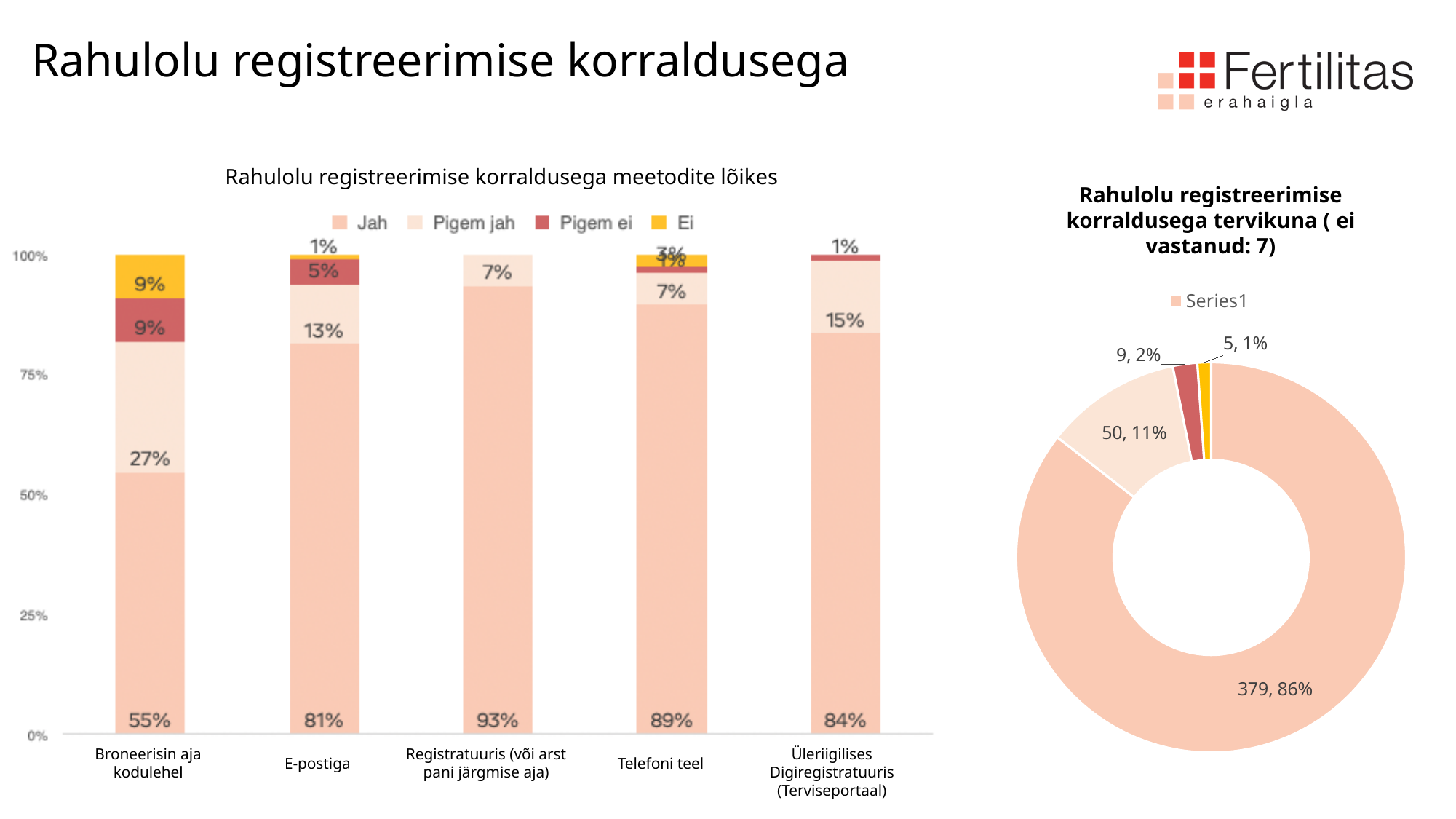
In the chart 'Rahulolu registreerimise korraldusega meetodite lõikes', is the 'Pigem jah' value larger for 'E-postiga' or for 'Üleriigilises Digiregistratuuris (Terviseportaal)'? Üleriigilises Digiregistratuuris (Terviseportaal) In the chart 'Rahulolu registreerimise korraldusega meetodite lõikes', what is the 'Pigem jah' value for 'Broneerisin aja kodulehel'? 27% What kind of chart is 'Rahulolu registreerimise korraldusega tervikuna'? Doughnut chart In the chart 'Rahulolu registreerimise korraldusega tervikuna', what is the value of the largest slice? 379 What kind of chart is 'Rahulolu registreerimise korraldusega meetodite lõikes'? Stacked bar chart In the chart 'Rahulolu registreerimise korraldusega meetodite lõikes', what is the difference between the 'Jah' values for 'Telefoni teel' and 'Üleriigilises Digiregistratuuris (Terviseportaal)'? 5% In the chart 'Rahulolu registreerimise korraldusega meetodite lõikes', which category has the lowest 'Jah' value? Broneerisin aja kodulehel In the chart 'Rahulolu registreerimise korraldusega meetodite lõikes', which category has the highest 'Jah' value? Registratuuris (või arst pani järgmise aja) How many categories are shown on the x axis of the chart 'Rahulolu registreerimise korraldusega meetodite lõikes'? 5 In the chart 'Rahulolu registreerimise korraldusega meetodite lõikes', what is the 'Jah' value for 'E-postiga'? 81% In the chart 'Rahulolu registreerimise korraldusega tervikuna', what share does the slice with value 50 have? 11% How many series does the legend of the chart 'Rahulolu registreerimise korraldusega meetodite lõikes' list? 4